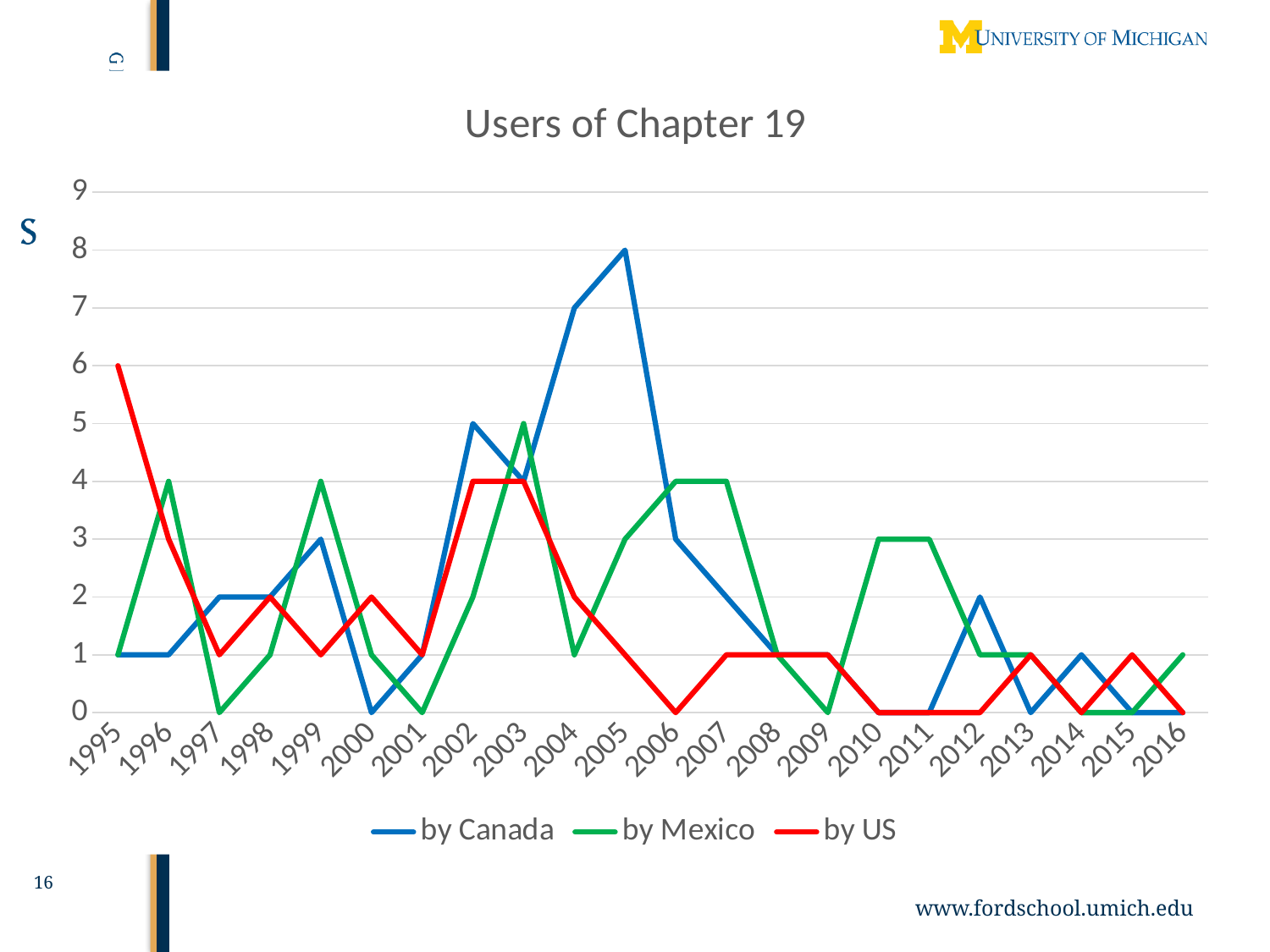
What is the difference between the 'by Canada' value in 2005 and the 'by Mexico' value in 2005? 5 What is the value for 'by Canada' in 2005? 8 What kind of chart is shown on the slide? line chart What is the title of the chart? Users of Chapter 19 How many series does the legend list? 3 What is the value for 'by Mexico' in 2003? 5 Which series has the higher value in 2005, 'by Canada' or 'by Mexico'? by Canada How many years are shown along the x axis? 22 In which year does the 'by Canada' series reach its highest value? 2005 Does the 'by US' series rise or fall from 1995 to 1997? fall What is the value for 'by Mexico' in 1996? 4 What is the value for 'by US' in 1995? 6